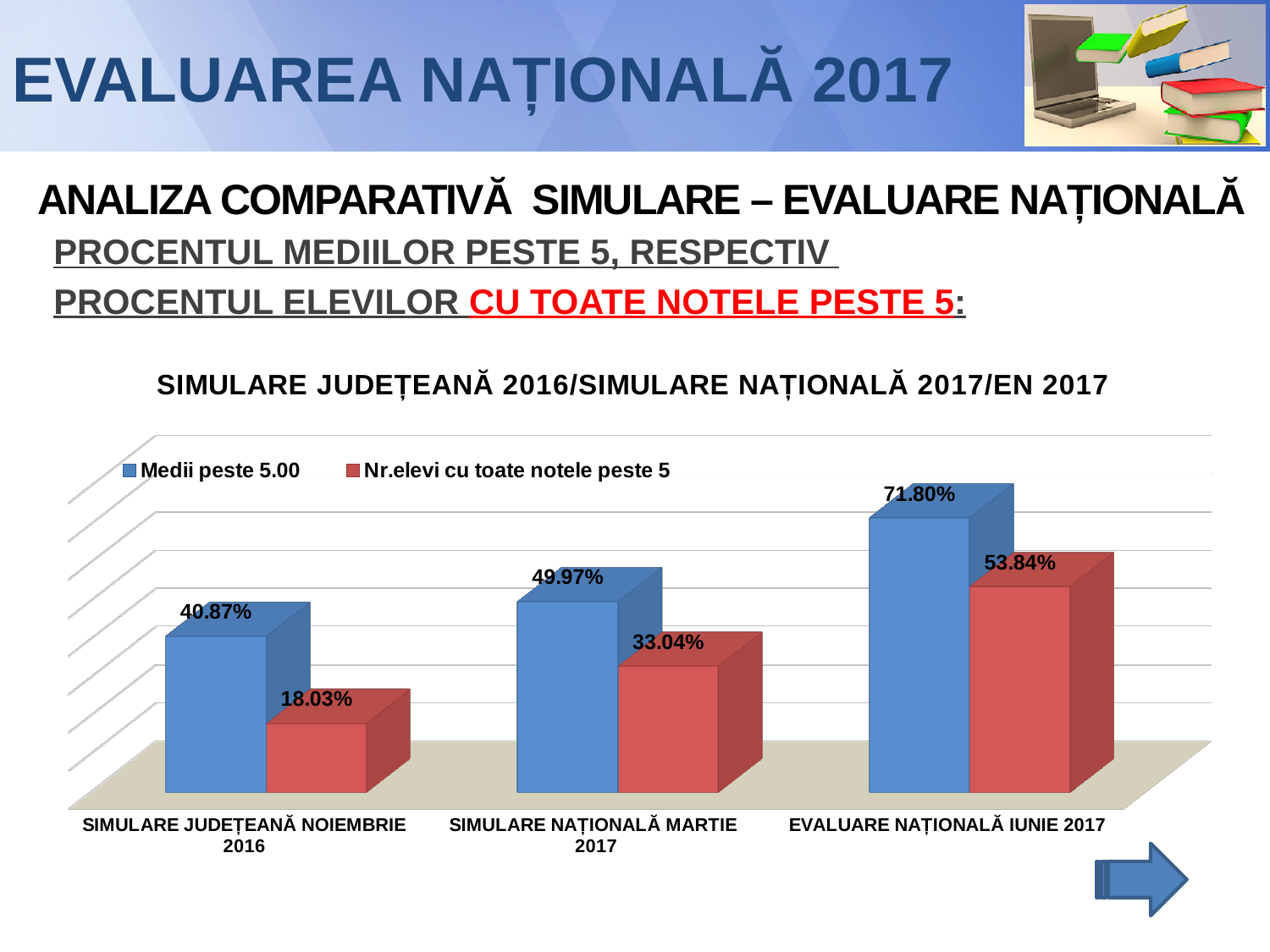
What is the value of 'Nr.elevi cu toate notele peste 5' for SIMULARE NAȚIONALĂ MARTIE 2017? 33.04% What is the difference in 'Medii peste 5.00' between EVALUARE NAȚIONALĂ IUNIE 2017 and SIMULARE NAȚIONALĂ MARTIE 2017? 21.83% What is the value of 'Medii peste 5.00' for SIMULARE JUDEȚEANĂ NOIEMBRIE 2016? 40.87% What is the difference between 'Medii peste 5.00' and 'Nr.elevi cu toate notele peste 5' for SIMULARE JUDEȚEANĂ NOIEMBRIE 2016? 22.84% How many categories are shown on the x axis of the chart? 3 Which is larger: 'Nr.elevi cu toate notele peste 5' for SIMULARE NAȚIONALĂ MARTIE 2017 or 'Medii peste 5.00' for SIMULARE JUDEȚEANĂ NOIEMBRIE 2016? 'Medii peste 5.00' for SIMULARE JUDEȚEANĂ NOIEMBRIE 2016 Which category has the highest value for 'Medii peste 5.00'? EVALUARE NAȚIONALĂ IUNIE 2017 What is the value of 'Nr.elevi cu toate notele peste 5' for EVALUARE NAȚIONALĂ IUNIE 2017? 53.84% How many series does the chart legend list? 2 What is the value of 'Medii peste 5.00' for EVALUARE NAȚIONALĂ IUNIE 2017? 71.80% Do the values for 'Medii peste 5.00' rise or fall from left to right across the categories? rise Which category has the lowest value for 'Nr.elevi cu toate notele peste 5'? SIMULARE JUDEȚEANĂ NOIEMBRIE 2016